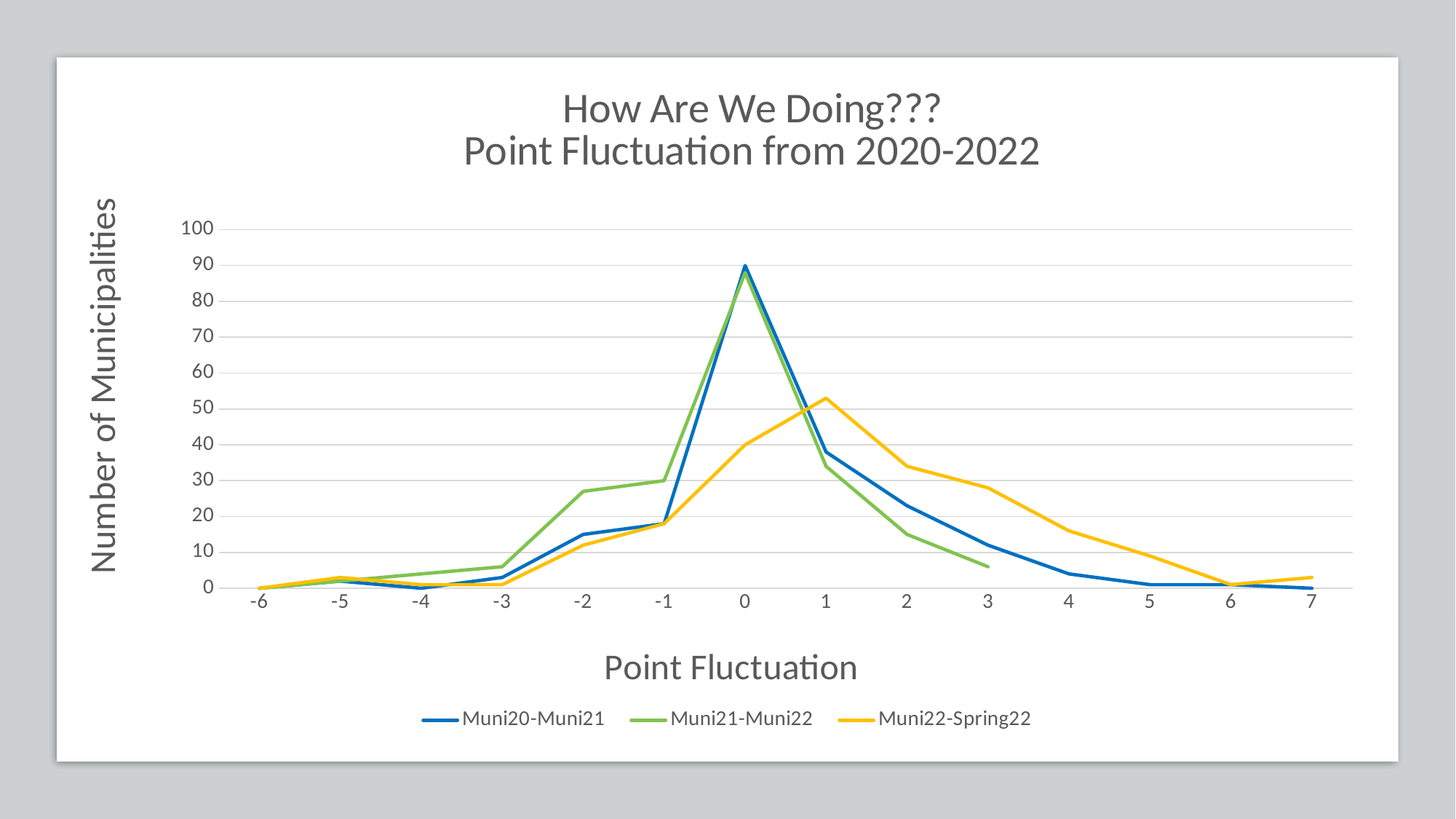
At which point fluctuation does the Muni20-Muni21 series reach its highest value? 0 What is the title of the y axis? Number of Municipalities Is the value for Muni22-Spring22 at point fluctuation 1 greater or less than 60? less At which point fluctuation does the Muni22-Spring22 series reach its highest value? 1 Is the value for Muni20-Muni21 at point fluctuation 0 greater or less than 80? greater At point fluctuation -2, which series has the larger value: Muni21-Muni22 or Muni20-Muni21? Muni21-Muni22 How many point fluctuation categories are shown on the x axis? 14 Is the value for Muni21-Muni22 at point fluctuation 2 greater or less than 20? less At point fluctuation 1, which series has the larger value: Muni22-Spring22 or Muni20-Muni21? Muni22-Spring22 What kind of chart is shown on the slide? line chart Does the Muni20-Muni21 series rise or fall from point fluctuation 0 to 7? fall How many series does the legend list? 3